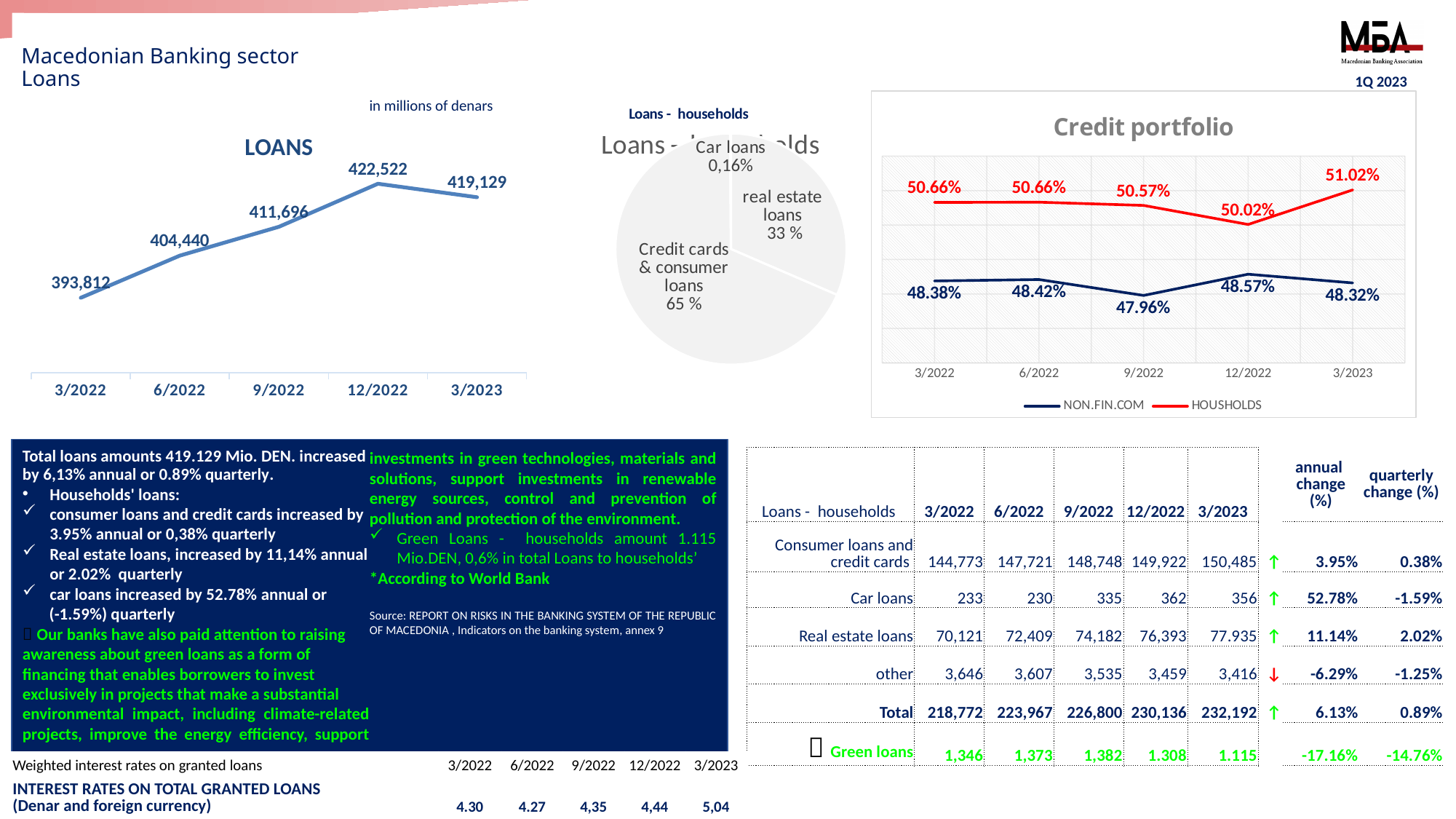
In the Loans - households pie chart, which slice is the largest? Credit cards & consumer loans In the Loans - households pie chart, what share do real estate loans have? 33 % In the Credit portfolio chart, what is the NON.FIN.COM value for 9/2022? 47.96% In the LOANS chart, how many periods are plotted? 5 In the LOANS chart, what is the difference between the values for 12/2022 and 3/2023? 3,393 In the LOANS chart, what is the value for 3/2022? 393,812 In the Credit portfolio chart, what is the HOUSHOLDS value for 3/2023? 51.02% In the LOANS chart, what is the value for 12/2022? 422,522 In the LOANS chart, which period has the lowest value? 3/2022 What kind of chart is the LOANS chart? line chart In the Credit portfolio chart, how many series does the legend list? 2 In the LOANS chart, which period has the highest value? 12/2022